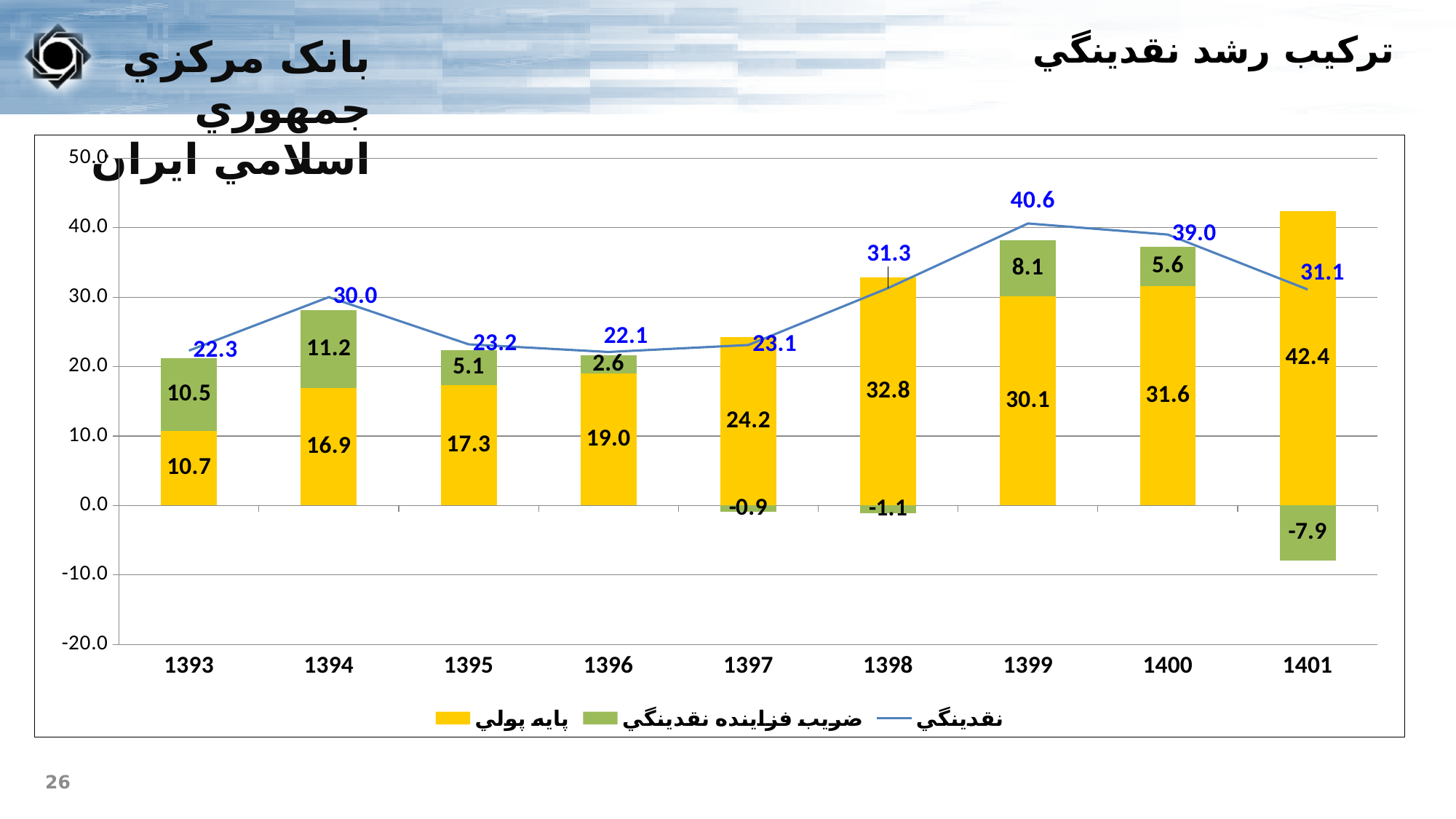
What is the value of the ضريب فزاينده نقدينگي (money multiplier) bar for 1394? 11.2 What kind of chart is shown on the slide? Combined stacked bar and line chart What is the value of the پايه پولي (monetary base) bar for 1401? 42.4 What colour represents پايه پولي (monetary base) in the chart? Yellow Does the پايه پولي (monetary base) value rise or fall from 1393 to 1398? Rise How many series does the legend list? 3 In which year is the نقدینگي (liquidity) line at its highest? 1399 What is the difference between the نقدینگي (liquidity) values for 1399 and 1393? 18.3 How many years are shown on the x axis? 9 What is the value of the نقدینگي (liquidity) line for 1399? 40.6 Which is larger: the پايه پولي (monetary base) value for 1398 or for 1399? 1398 In which year is the ضريب فزاينده نقدينگي (money multiplier) value lowest? 1401